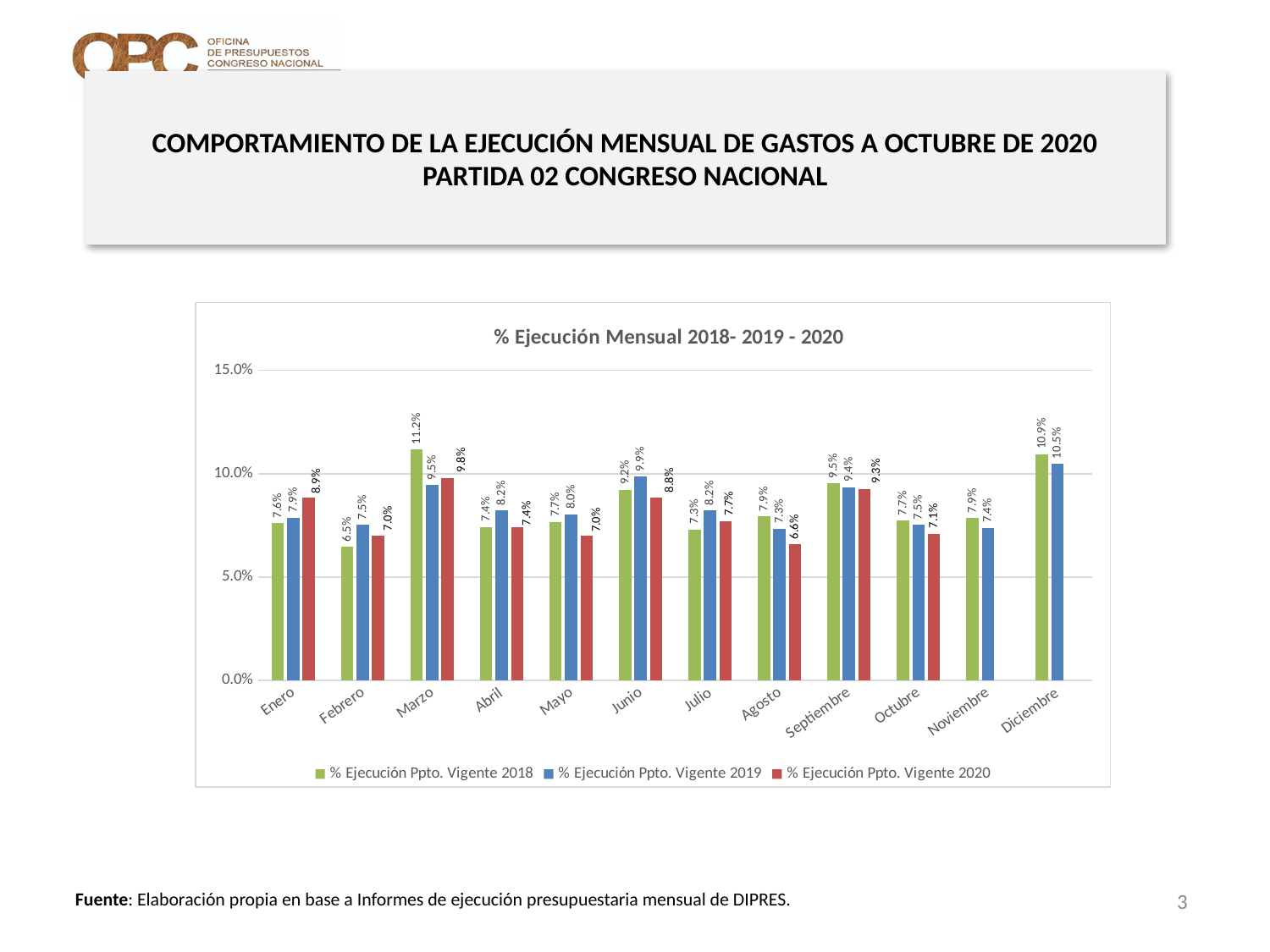
What is the value for Diciembre in the % Ejecución Ppto. Vigente 2019 series? 10.5% What is the difference between the 2018 and 2019 values for Marzo? 1.7% What is the value for Agosto in the % Ejecución Ppto. Vigente 2020 series? 6.6% How many months are shown on the x axis of the chart? 12 For Junio, which series has the larger value: % Ejecución Ppto. Vigente 2019 or % Ejecución Ppto. Vigente 2020? % Ejecución Ppto. Vigente 2019 What is the value for Marzo in the % Ejecución Ppto. Vigente 2018 series? 11.2% Which month has the lowest value in the % Ejecución Ppto. Vigente 2020 series? Agosto Which month has the highest value in the % Ejecución Ppto. Vigente 2018 series? Marzo How many series does the legend list? 3 What kind of chart is shown on the slide? Bar chart What is the title of the chart? % Ejecución Mensual 2018- 2019 - 2020 Is the value for Diciembre in the % Ejecución Ppto. Vigente 2018 series greater or less than 10.0%? greater